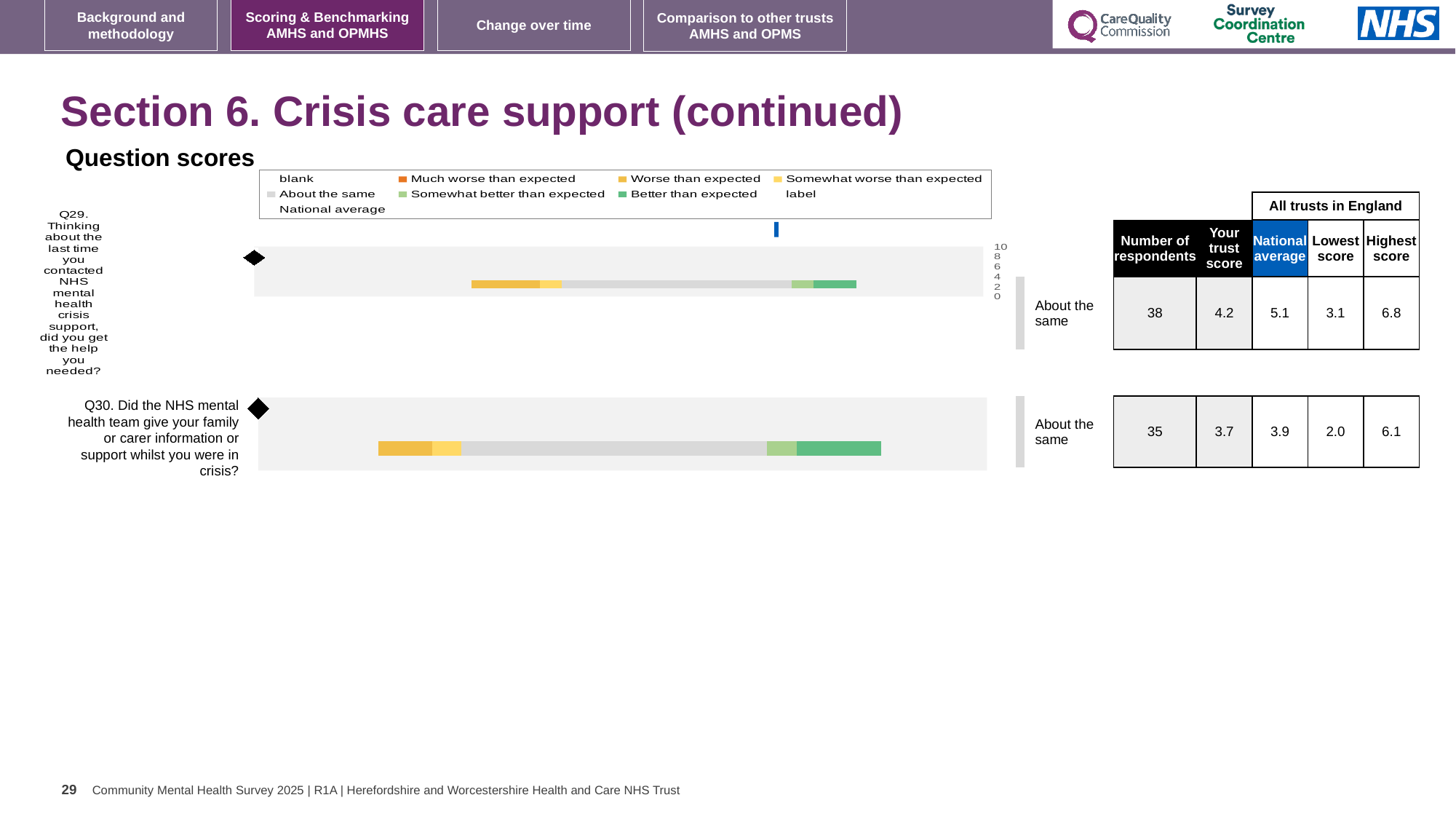
What kind of chart is used to show the question scores for Q29 and Q30? bar chart What is the difference between the highest score and the lowest score for Q30? 4.1 Which colour in the legend represents 'Better than expected'? green Which is larger for Q29, the trust score or the national average? national average How many questions are plotted in the question scores chart? 2 What is the highest score among all trusts in England for Q29? 6.8 Which question had more respondents, Q29 or Q30? Q29 What benchmark category is shown for Q30 next to the chart? About the same What is the difference between the national average and the trust score for Q29? 0.9 How many respondents answered Q30? 35 What is the national average for Q30 shown next to the chart? 3.9 What is the trust score for Q29 shown next to the chart? 4.2